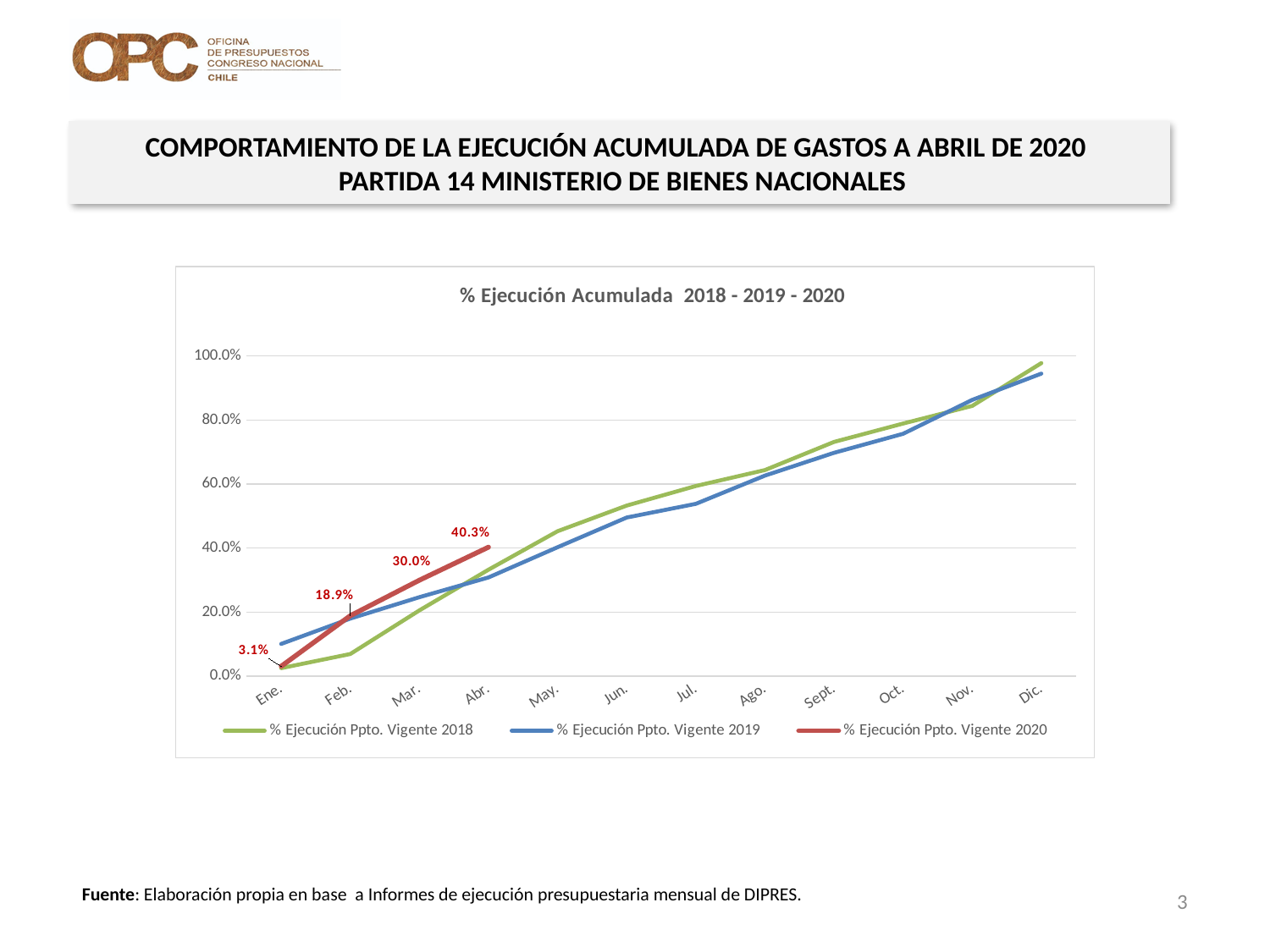
What is the title of the chart? % Ejecución Acumulada 2018 - 2019 - 2020 Does the % Ejecución Ppto. Vigente 2020 line rise or fall from Ene. to Abr.? Rise What is the value of % Ejecución Ppto. Vigente 2020 for Abr.? 40.3% By how much did % Ejecución Ppto. Vigente 2020 increase from Mar. to Abr.? 10.3% Is the value for % Ejecución Ppto. Vigente 2019 in Dic. greater or less than 80.0%? greater How many series does the legend list? 3 How many months are shown on the x axis? 12 What is the value of % Ejecución Ppto. Vigente 2020 for Mar.? 30.0% What kind of chart is shown on the slide? Line chart What is the value of % Ejecución Ppto. Vigente 2020 for Feb.? 18.9% In Ene., which series has the higher value: % Ejecución Ppto. Vigente 2018 or % Ejecución Ppto. Vigente 2019? % Ejecución Ppto. Vigente 2019 What is the value of % Ejecución Ppto. Vigente 2020 for Ene.? 3.1%